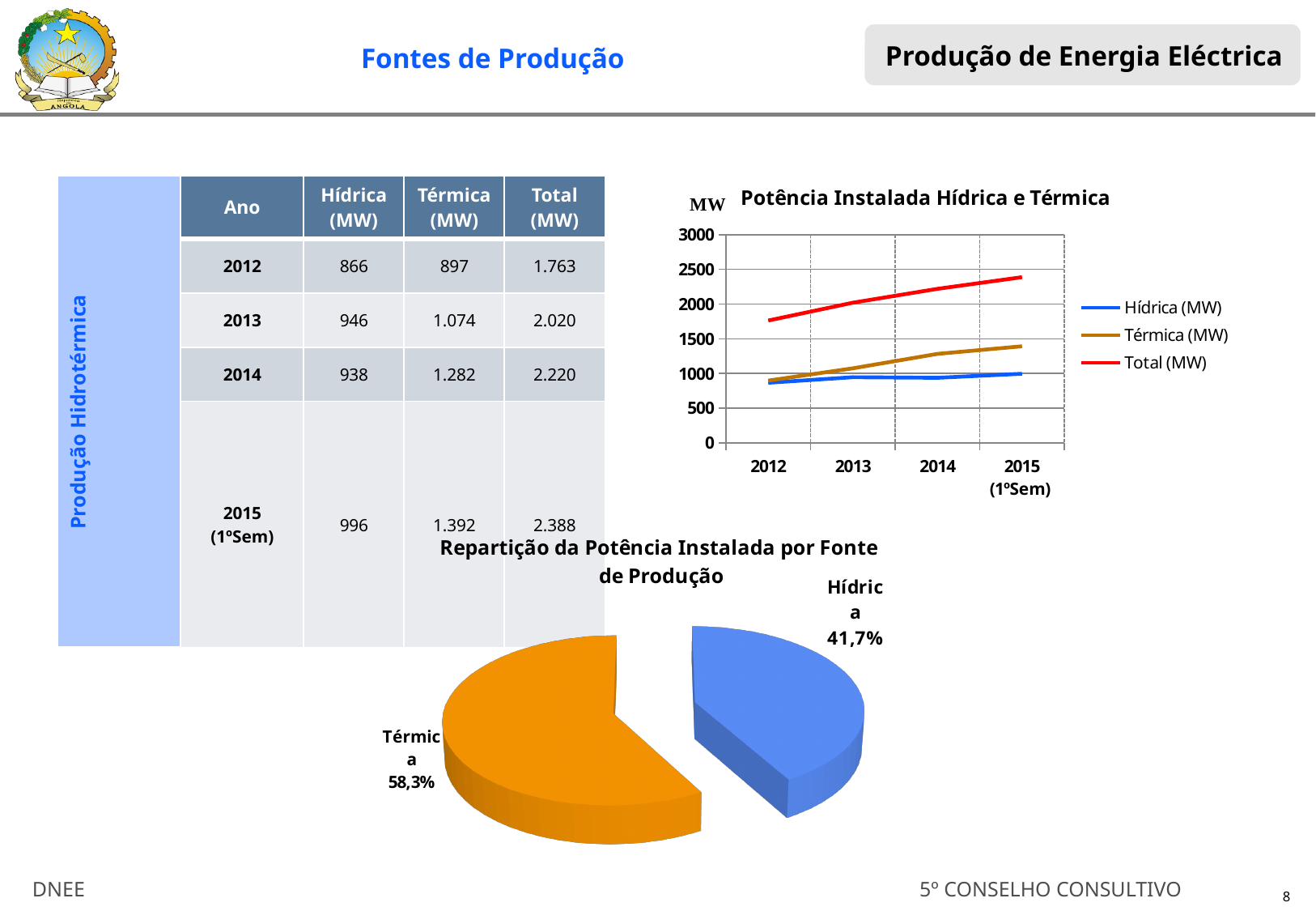
In the 'Repartição da Potência Instalada por Fonte de Produção' pie chart, which slice is larger, Hídrica or Térmica? Térmica In the 'Potência Instalada Hídrica e Térmica' chart, does the Total (MW) line rise or fall from 2012 to 2015 (1ºSem)? rise In the 'Potência Instalada Hídrica e Térmica' chart, is the Térmica (MW) value for 2015 (1ºSem) greater or less than 1500? less In the 'Potência Instalada Hídrica e Térmica' chart, is the Total (MW) value for 2012 greater or less than 2000? less What kind of chart is 'Repartição da Potência Instalada por Fonte de Produção'? pie chart How many years are shown on the x axis of the 'Potência Instalada Hídrica e Térmica' chart? 4 In the 'Potência Instalada Hídrica e Térmica' chart, which colour is used for the Total (MW) line? red In the 'Potência Instalada Hídrica e Térmica' chart, which series has the highest values across all years? Total (MW) How many series does the legend of the 'Potência Instalada Hídrica e Térmica' chart list? 3 In the 'Repartição da Potência Instalada por Fonte de Produção' pie chart, what share does Térmica have? 58,3% In the 'Potência Instalada Hídrica e Térmica' chart, is the Hídrica (MW) value for 2012 greater or less than 1000? less What kind of chart is the 'Potência Instalada Hídrica e Térmica' chart? line chart